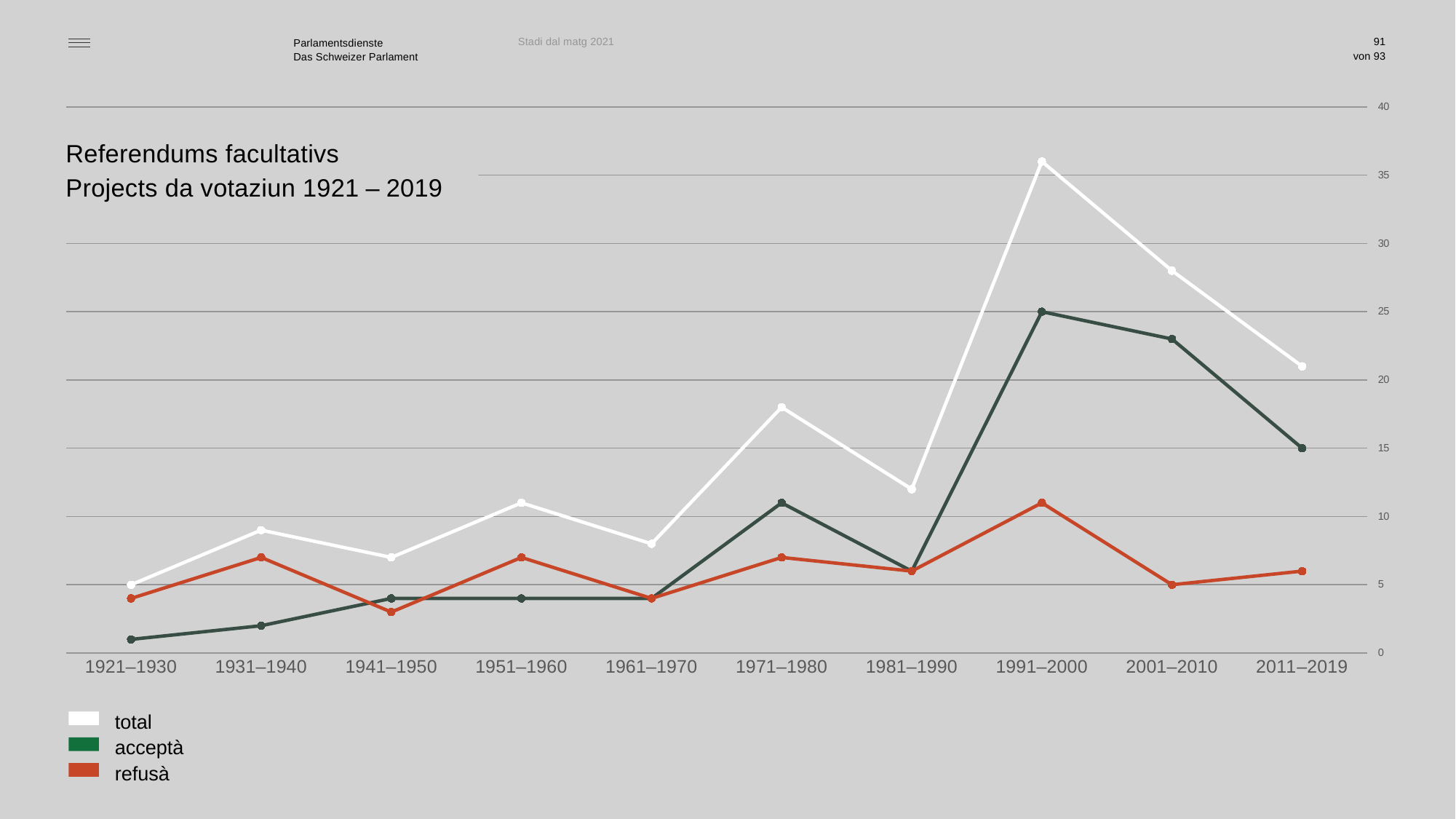
Is the value of the total series for 2001–2010 greater or less than 25? greater For 2001–2010, which is larger: acceptà or refusà? acceptà What kind of chart is shown on the slide? line chart Does the total series rise or fall from 1991–2000 to 2011–2019? fall In which period does the refusà series reach its highest value? 1991–2000 How many series does the legend list? 3 Is the value of the total series for 1991–2000 greater or less than 30? greater In which period does the total series reach its highest value? 1991–2000 What is the value of the acceptà series for 2011–2019? 15 What is the value of the acceptà series for 1991–2000? 25 In which period is the acceptà series at its lowest? 1921–1930 How many decade periods are shown on the x axis? 10